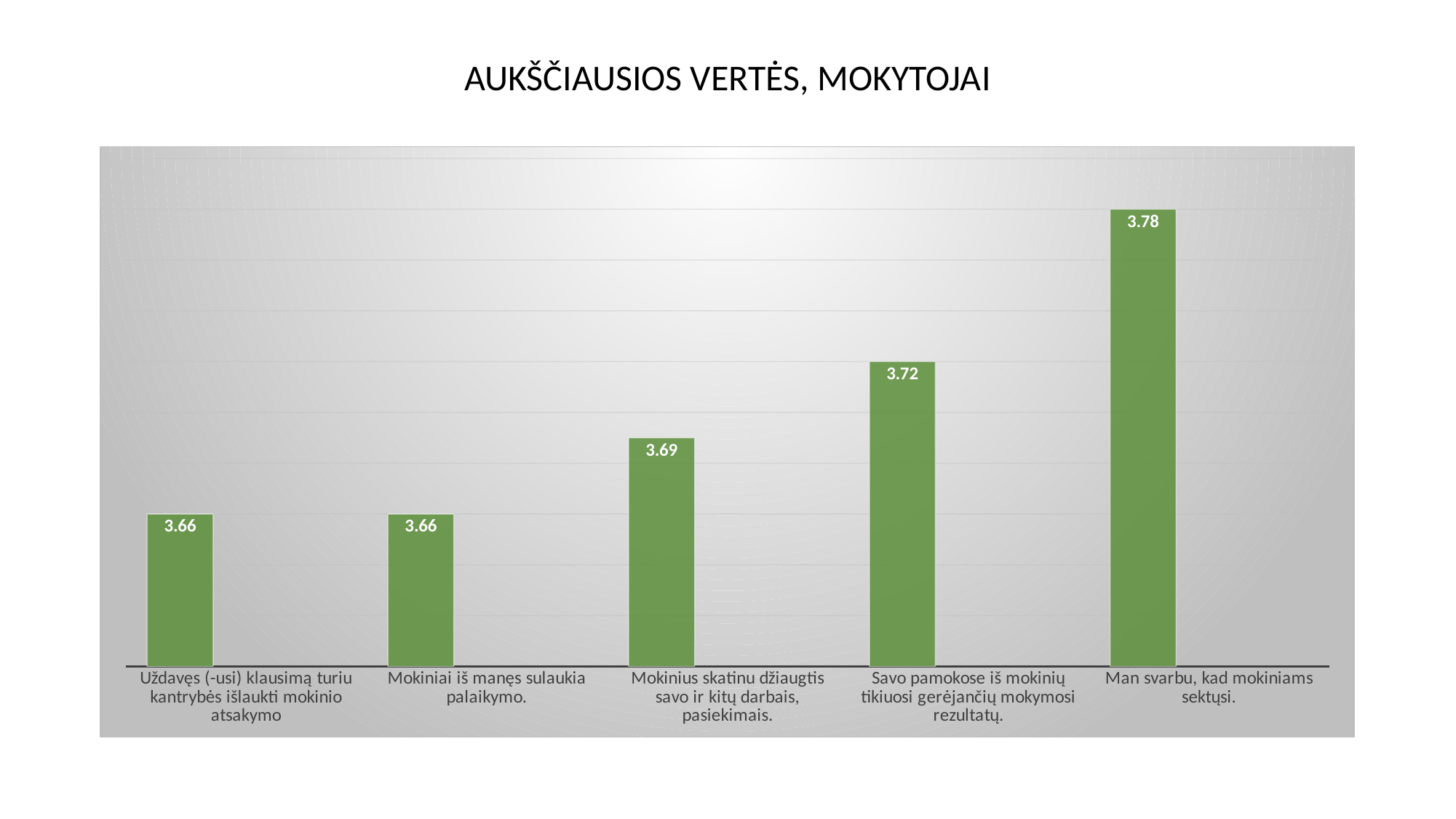
What is the value for "Savo pamokose iš mokinių tikiuosi gerėjančių mokymosi rezultatų."? 3.72 What is the value for "Mokinius skatinu džiaugtis savo ir kitų darbais, pasiekimais."? 3.69 Which is larger: the value for "Savo pamokose iš mokinių tikiuosi gerėjančių mokymosi rezultatų." or the value for "Mokinius skatinu džiaugtis savo ir kitų darbais, pasiekimais."? Savo pamokose iš mokinių tikiuosi gerėjančių mokymosi rezultatų. What kind of chart is shown on the slide? Bar chart What is the difference between the values for "Man svarbu, kad mokiniams sektųsi." and "Savo pamokose iš mokinių tikiuosi gerėjančių mokymosi rezultatų."? 0.06 How many categories are shown in the chart? 5 What is the value for "Man svarbu, kad mokiniams sektųsi."? 3.78 What is the difference between the values for "Mokinius skatinu džiaugtis savo ir kitų darbais, pasiekimais." and "Mokiniai iš manęs sulaukia palaikymo."? 0.03 Do the values rise or fall from left to right along the x axis? Rise What is the title of the slide? AUKŠČIAUSIOS VERTĖS, MOKYTOJAI Which category has the highest value? Man svarbu, kad mokiniams sektųsi. What is the value for "Mokiniai iš manęs sulaukia palaikymo."? 3.66